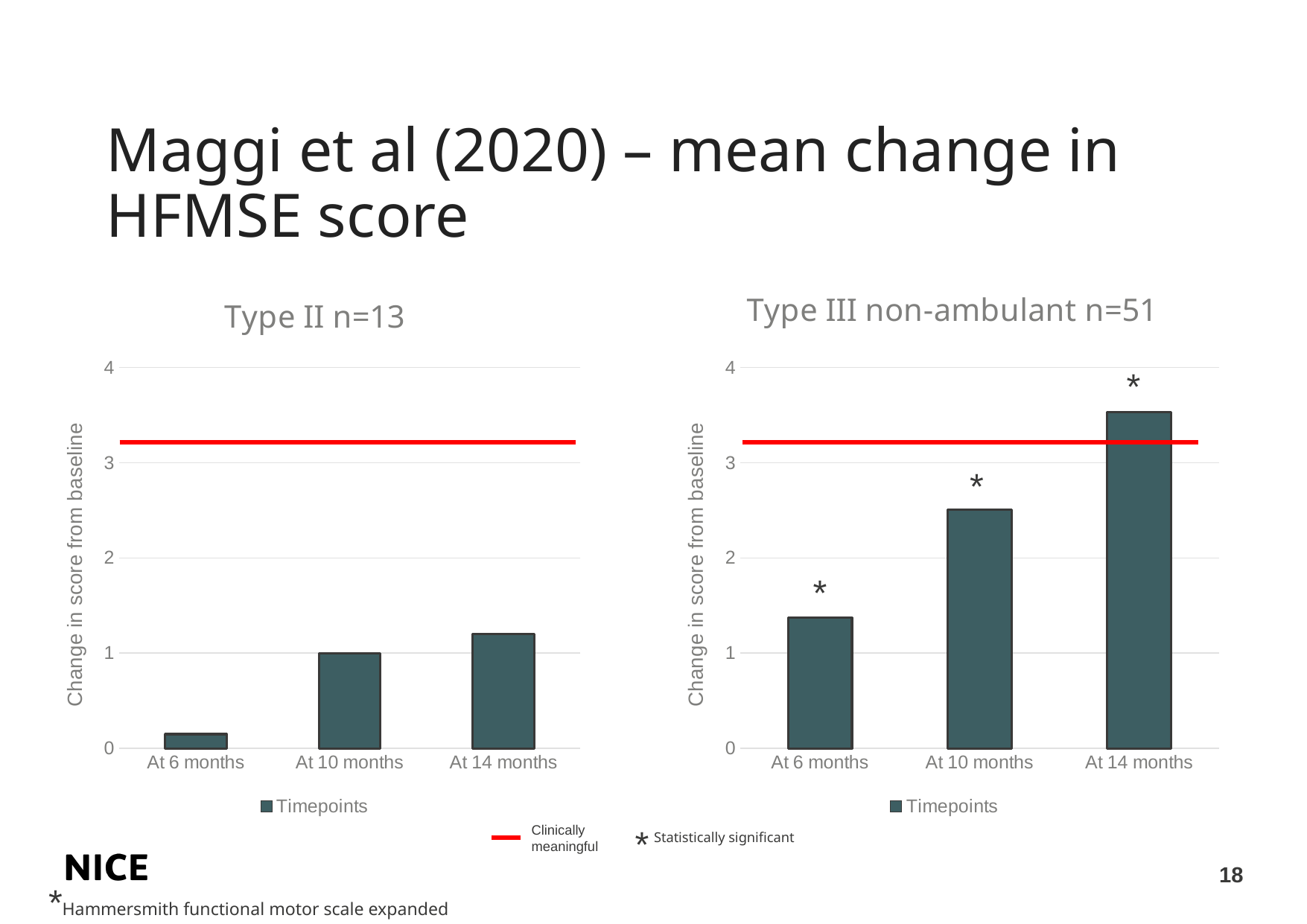
In the "Type III non-ambulant n=51" chart, is the value at 14 months greater or less than 3? greater In the "Type III non-ambulant n=51" chart, how many series does the legend list? 1 What does the red horizontal line on the charts represent, according to the legend? Clinically meaningful In the "Type II n=13" chart, is the value at 6 months greater or less than 1? less What kind of chart is the "Type II n=13" chart? Bar chart In the "Type II n=13" chart, how many timepoint categories are shown on the x axis? 3 In the "Type II n=13" chart, do the values rise or fall from 6 months to 14 months? Rise In the "Type III non-ambulant n=51" chart, which timepoint has the highest change in score from baseline? At 14 months In the "Type III non-ambulant n=51" chart, is the value at 10 months greater or less than 2? greater In the "Type II n=13" chart, which timepoint has the lowest change in score from baseline? At 6 months In the "Type III non-ambulant n=51" chart, do the values rise or fall from 6 months to 14 months? Rise In the "Type II n=13" chart, which is larger: the value at 10 months or at 14 months? At 14 months